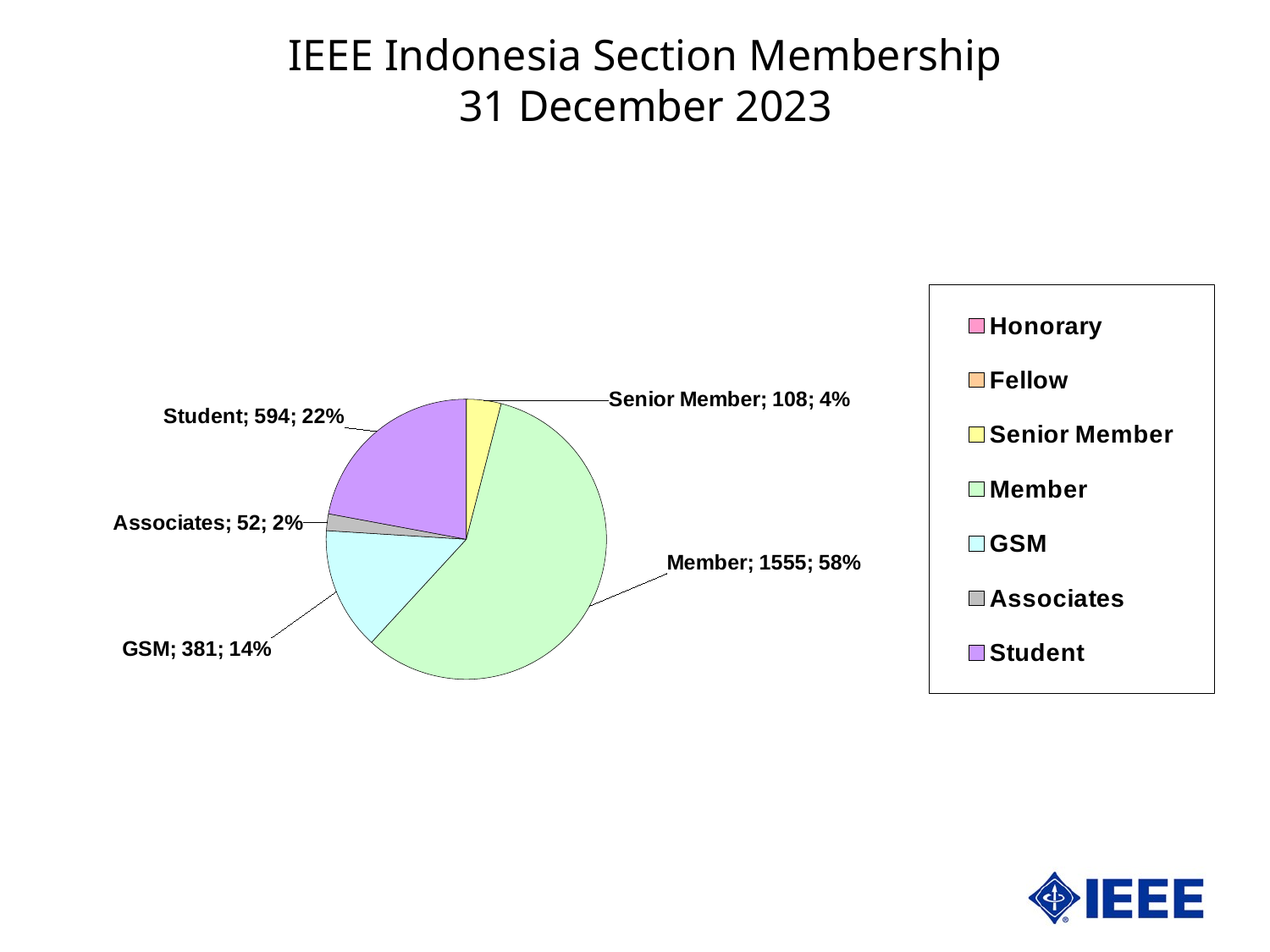
What is the value for GSM? 381 How many members are in the Student category? 594 What is the value for Senior Member? 108 What share of the pie does the Student slice represent? 22% Which labelled category has the smallest slice of the pie? Associates How many members are in the Member category? 1555 What share of the pie does the Member slice represent? 58% Which category has the largest slice of the pie? Member What is the difference between the Student value and the GSM value? 213 Which is larger, the value for GSM or the value for Senior Member? GSM How many entries does the legend list? 7 What type of chart is shown on the slide? Pie chart